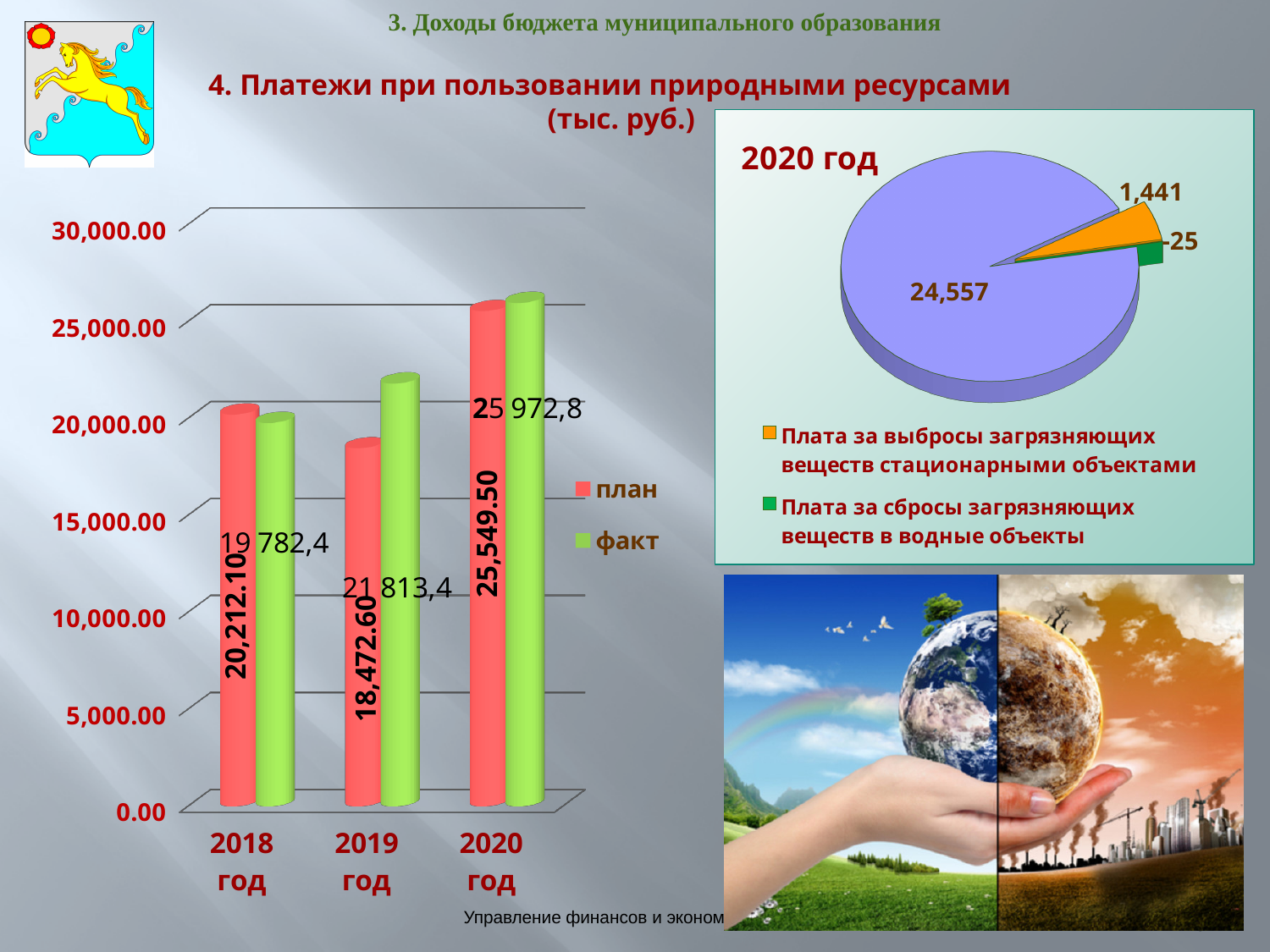
In the pie chart titled 2020 год, what is the value for Плата за выбросы загрязняющих веществ стационарными объектами? 1,441 In the bar chart, which year has the lowest план value? 2019 год In the bar chart, what is the план value for 2020 год? 25,549.50 In the bar chart, what is the план value for 2018 год? 20,212.10 In the bar chart, what is the факт value for 2020 год? 25 972,8 In the bar chart, for 2019 год, which is larger: план or факт? факт In the bar chart, which year has the highest план value? 2020 год What kind of chart is the chart on the left of the slide? bar chart How many series does the legend of the bar chart list? 2 In the bar chart, what is the факт value for 2019 год? 21 813,4 How many years are shown on the x axis of the bar chart? 3 What kind of chart is the chart titled 2020 год? pie chart